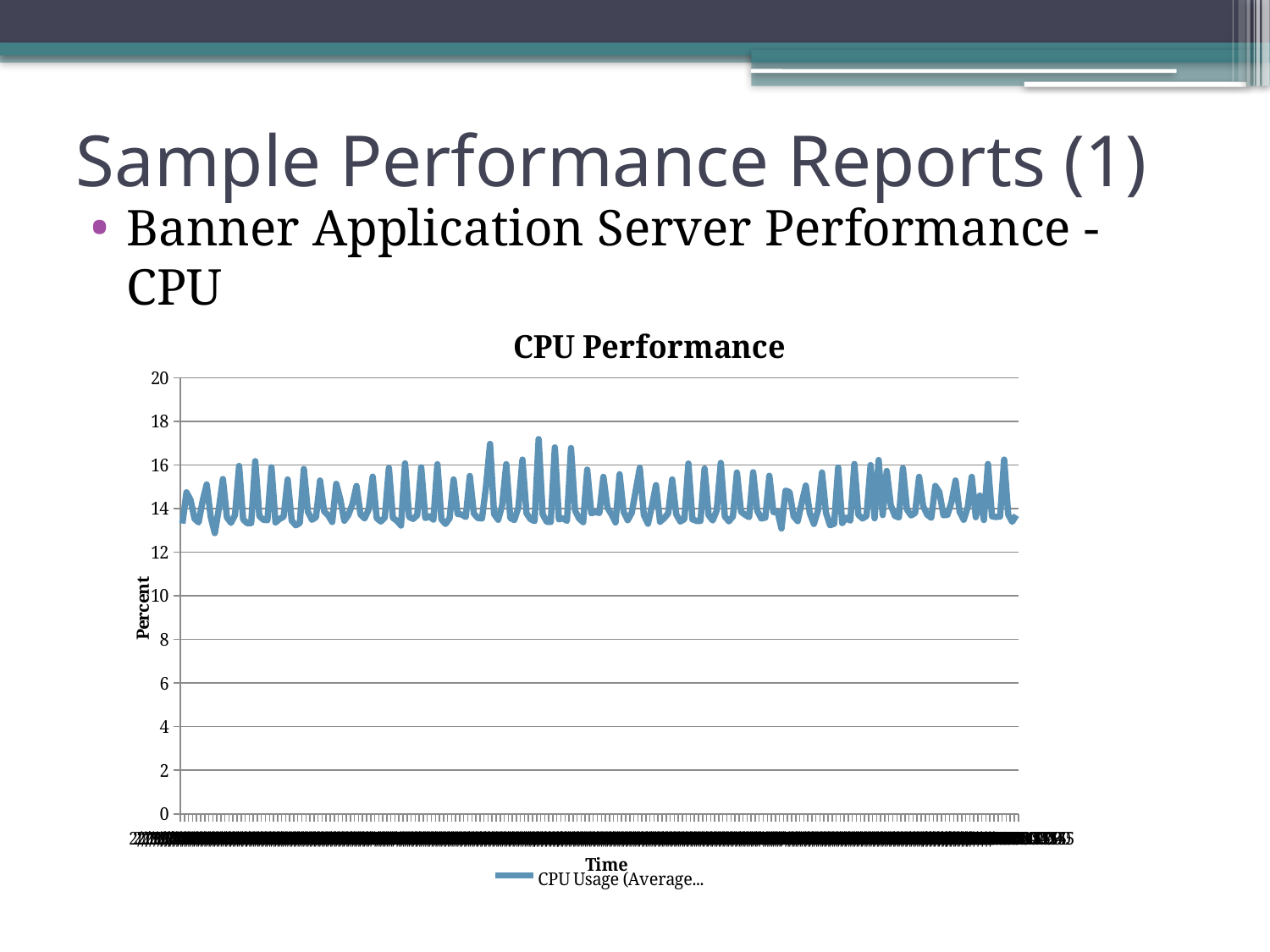
How many series does the chart's legend list? 1 Is the value of the CPU Usage line at the start of the time axis greater or less than 8? greater What is the title of the chart? CPU Performance Is the lowest value reached by the CPU Usage line greater or less than 10? greater Is the highest value reached by the CPU Usage line greater or less than 18? less What is the label on the vertical axis of the chart? Percent What kind of chart is shown on the slide? line chart